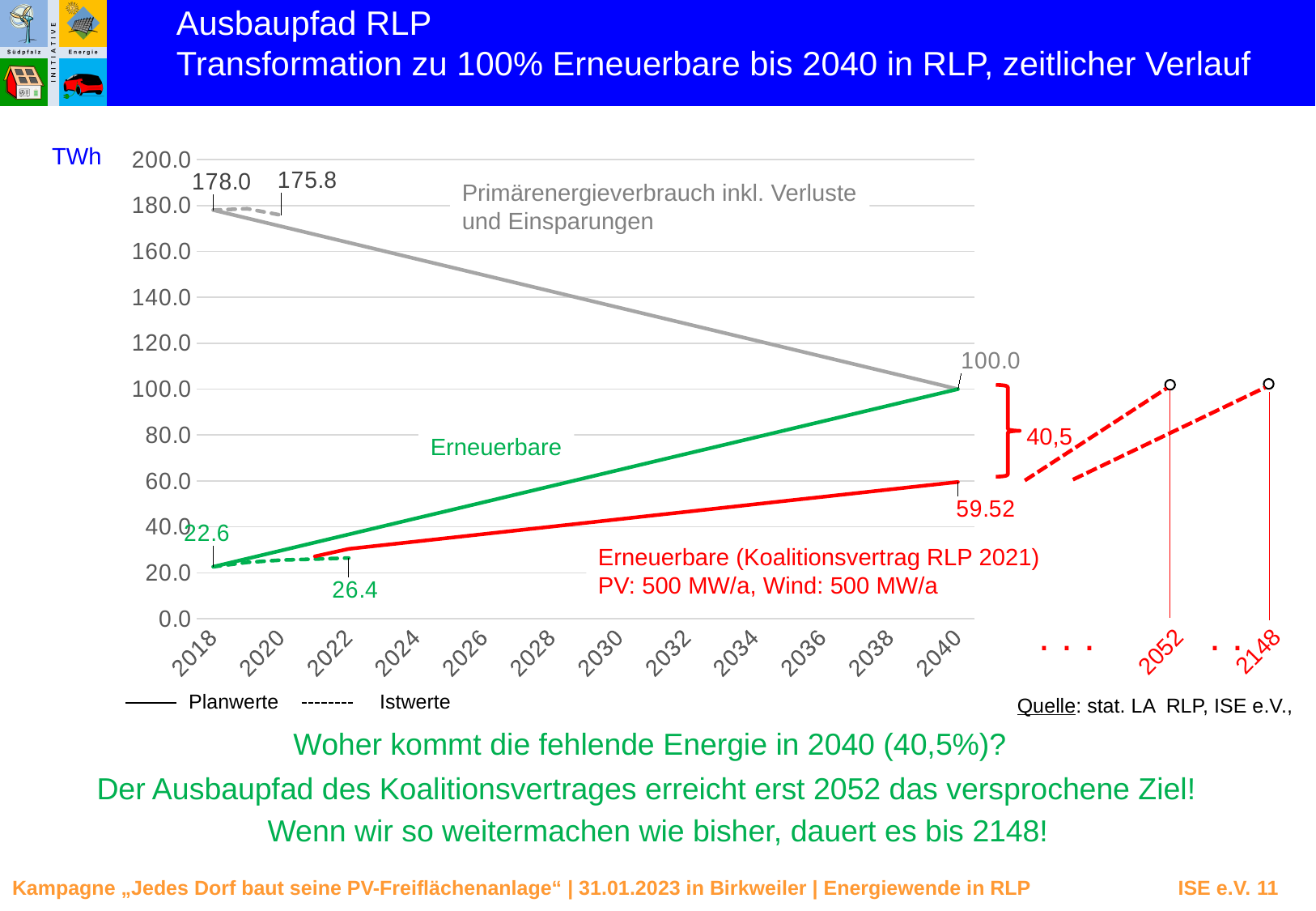
What is the labelled Istwert for Erneuerbare in 2022? 26.4 In 2040, which is larger: the green Erneuerbare line or the red Koalitionsvertrag line? green Erneuerbare line What unit is shown on the y axis? TWh Does the grey Primärenergieverbrauch line rise or fall from 2018 to 2040? fall Does the green Erneuerbare line rise or fall from 2018 to 2040? rise What is the starting value of the green Erneuerbare line in 2018? 22.6 What is the difference between the Primärenergieverbrauch value in 2018 (178.0) and in 2040 (100.0)? 78.0 What is the value of the Primärenergieverbrauch line in 2018? 178.0 What value does the red Erneuerbare (Koalitionsvertrag RLP 2021) line reach in 2040? 59.52 What are the two entries in the chart legend? Planwerte, Istwerte What type of chart is shown on the slide? line chart What value does the Primärenergieverbrauch line reach in 2040? 100.0